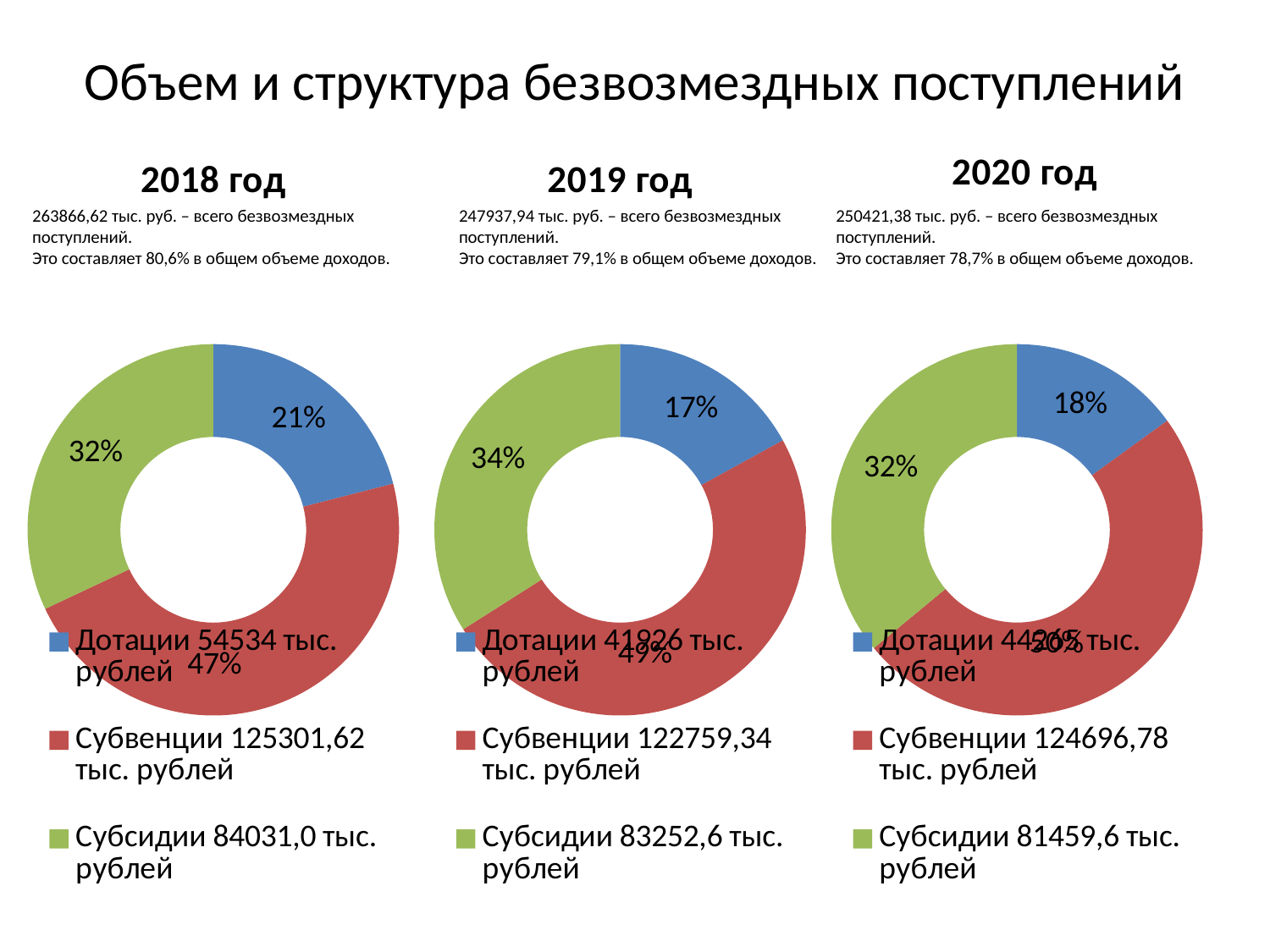
In the 2019 год chart, which category has the smallest slice? Дотации In the 2020 год chart, what share does the Субсидии slice have? 32% In the 2018 год chart, what share does the Дотации slice have? 21% What type of chart is used for the 2018 год chart? doughnut chart According to the legend of the 2018 год chart, what is the value of Субвенции? 125301,62 тыс. рублей In the 2018 год chart, which slice is larger, Субсидии or Дотации? Субсидии In the 2018 год chart, what share does the Субвенции slice have? 47% According to the legend of the 2020 год chart, what is the value of Субсидии? 81459,6 тыс. рублей How many categories does the legend of the 2020 год chart list? 3 In the 2020 год chart, which category has the largest slice? Субвенции